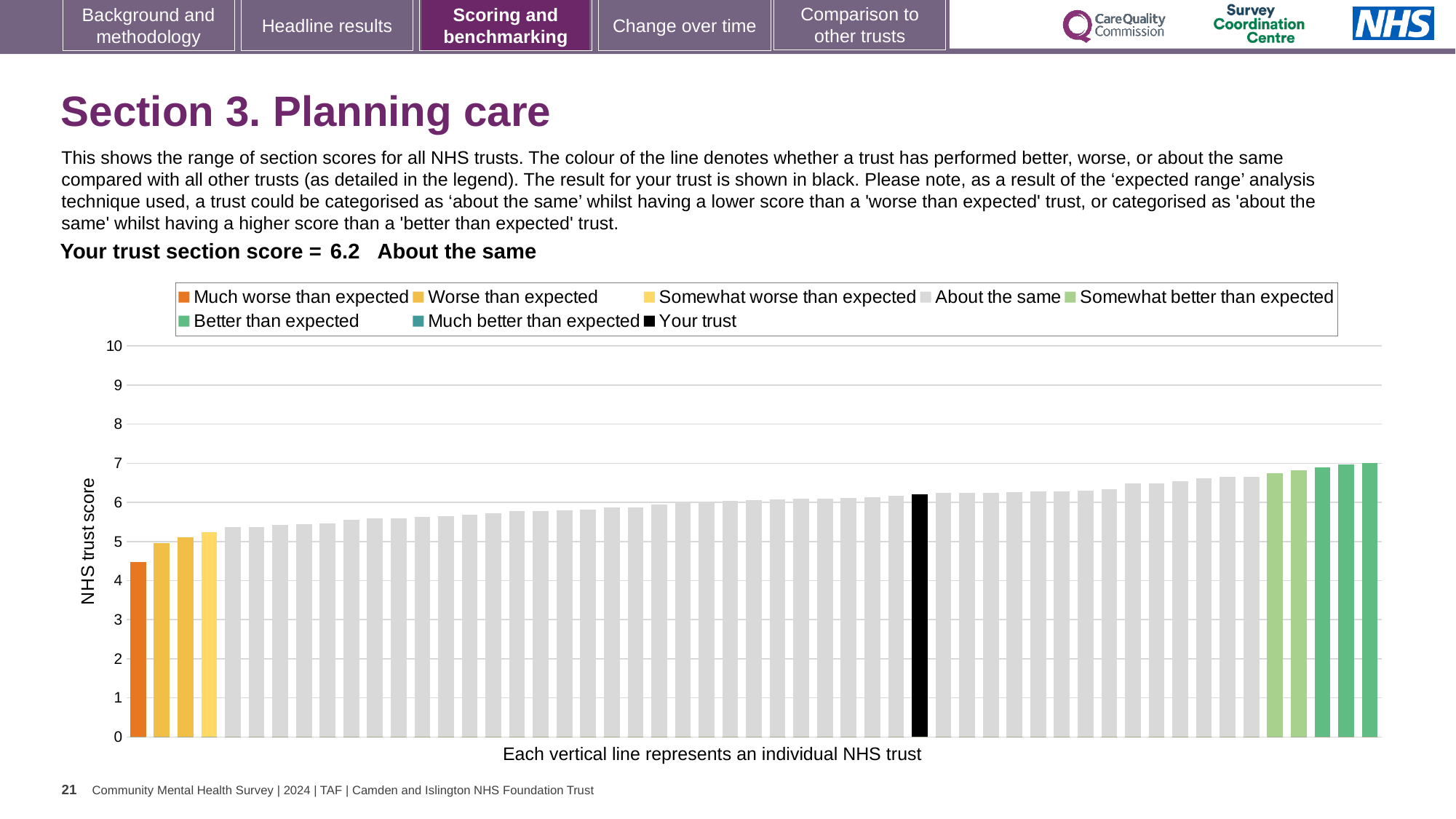
What is the label on the vertical axis of the chart? NHS trust score What colour is used for the bar representing your trust? Black Is the value of the leftmost (orange) bar greater or less than 5? less How many bars are coloured orange (Much worse than expected)? 1 Which is taller, the black bar for your trust or the orange bar? The black bar for your trust Is the value of the rightmost bar greater or less than 6? greater Which category is your trust placed in according to the text above the chart? About the same Do the bar values rise or fall from left to right along the x axis? rise What kind of chart is shown on the slide? Bar chart Is the value for your trust (the black bar) greater or less than 6? greater What is the section score for your trust shown on the slide? 6.2 How many entries does the chart legend list? 8